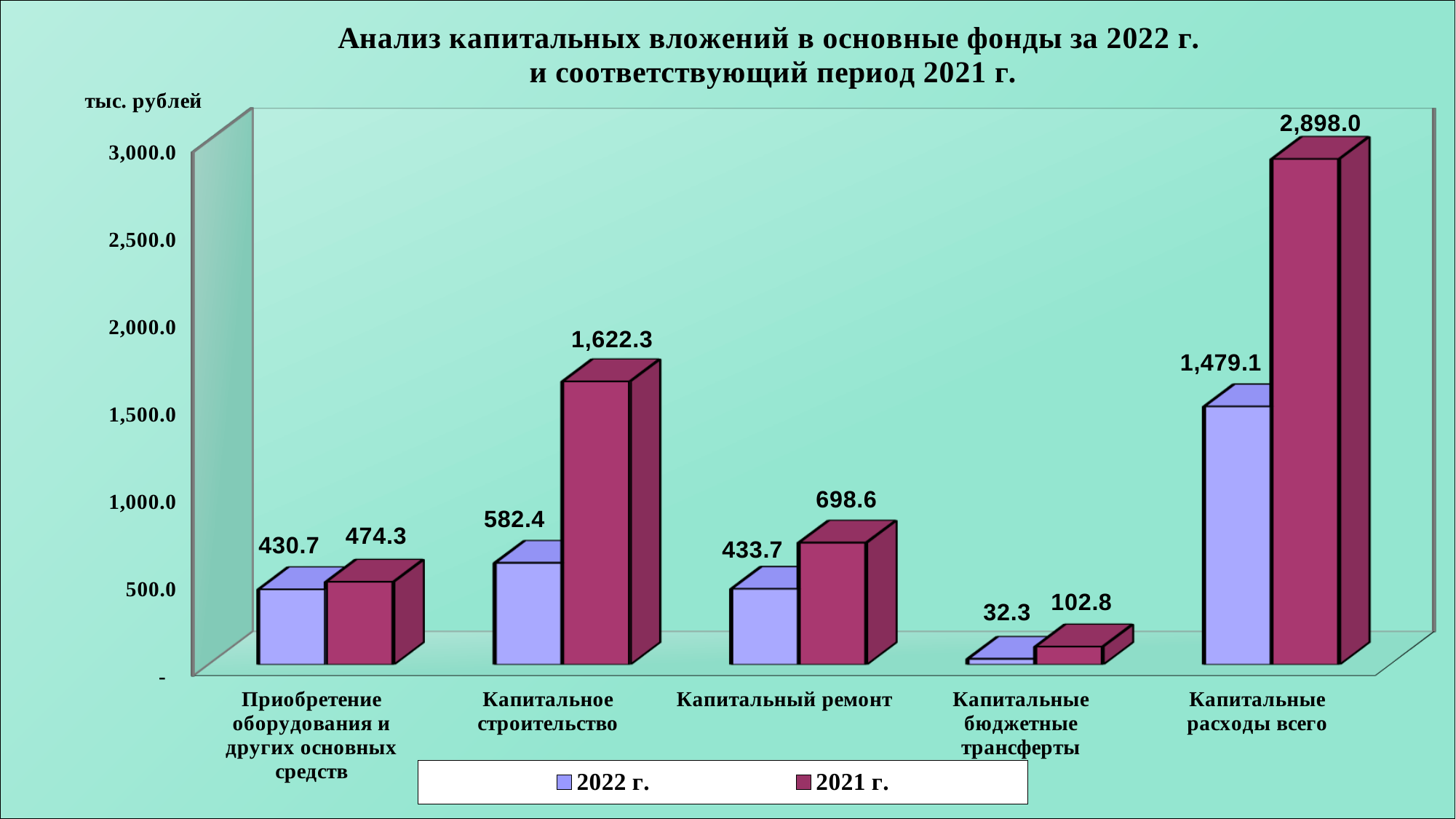
What is the value for 2021 г. in the category Капитальный ремонт? 698.6 Which is larger for Приобретение оборудования и других основных средств: the 2022 г. value or the 2021 г. value? 2021 г. What is the value for 2022 г. in the category Капитальные бюджетные трансферты? 32.3 Which category has the lowest value for 2022 г.? Капитальные бюджетные трансферты What is the value for 2021 г. in the category Капитальные расходы всего? 2,898.0 Which category has the highest value for 2021 г.? Капитальные расходы всего What is the value for 2022 г. in the category Капитальное строительство? 582.4 What kind of chart is shown on the slide? Bar chart How many series does the legend list? 2 What is the difference between the 2021 г. and 2022 г. values for Капитальное строительство? 1,039.9 How many categories are shown on the x axis? 5 What is the difference between the 2021 г. and 2022 г. values for Капитальные расходы всего? 1,418.9